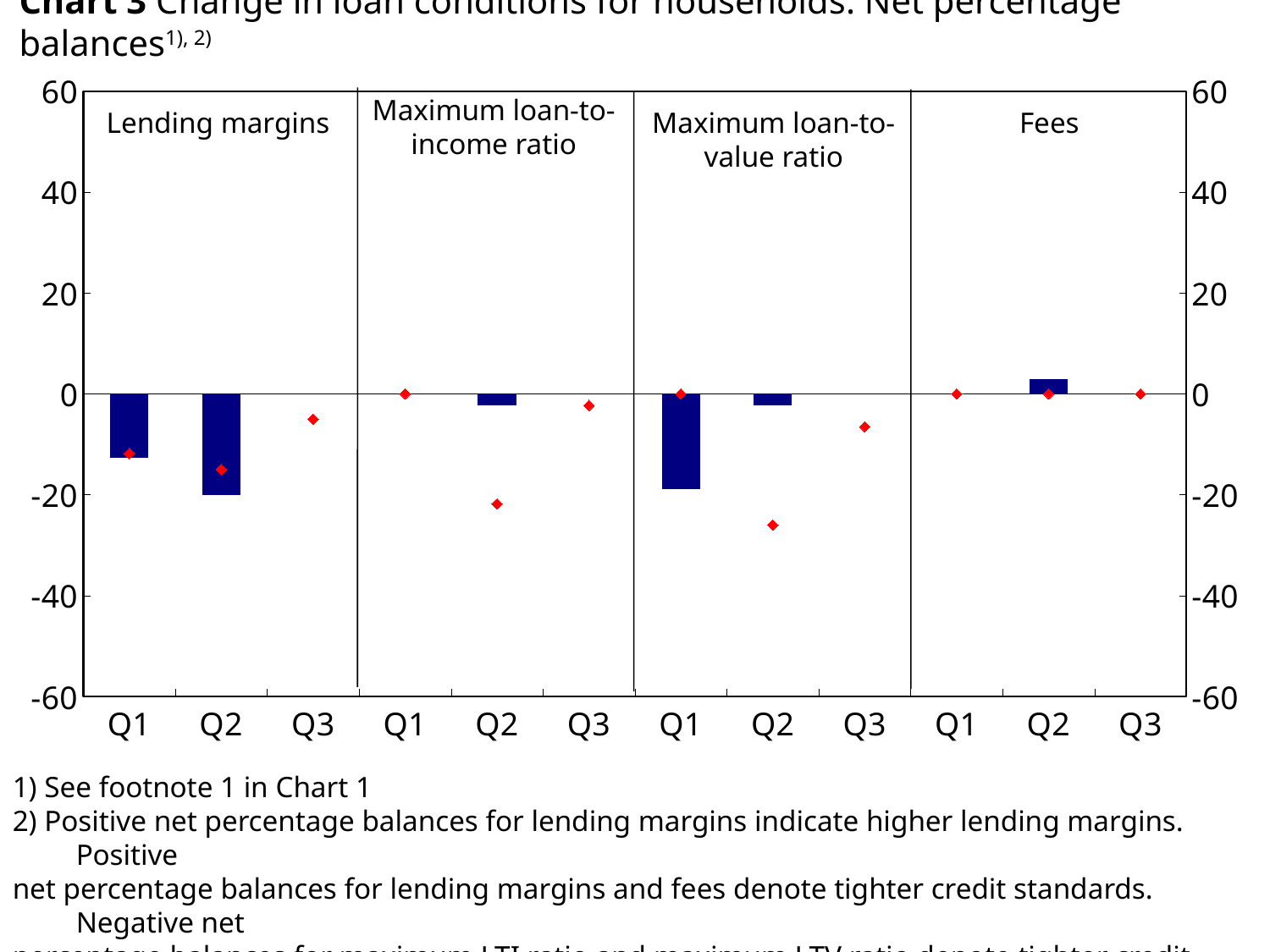
What is the maximum value shown on the vertical axis? 60 How many quarters are shown on the x axis within each panel? 3 In the Lending margins panel, which quarter has the lowest bar, Q1 or Q2? Q2 What is the title of the fourth (rightmost) panel of the chart? Fees In the Maximum loan-to-value ratio panel, is the bar for Q1 greater or less than -10? less In the Fees panel, is the bar for Q2 greater or less than 0? greater In the Lending margins panel, is the bar for Q2 greater or less than -10? less How many panels (loan condition categories) does the chart have? 4 What kind of chart is shown on the slide? bar chart In the Maximum loan-to-value ratio panel, which bar is lower, Q1 or Q2? Q1